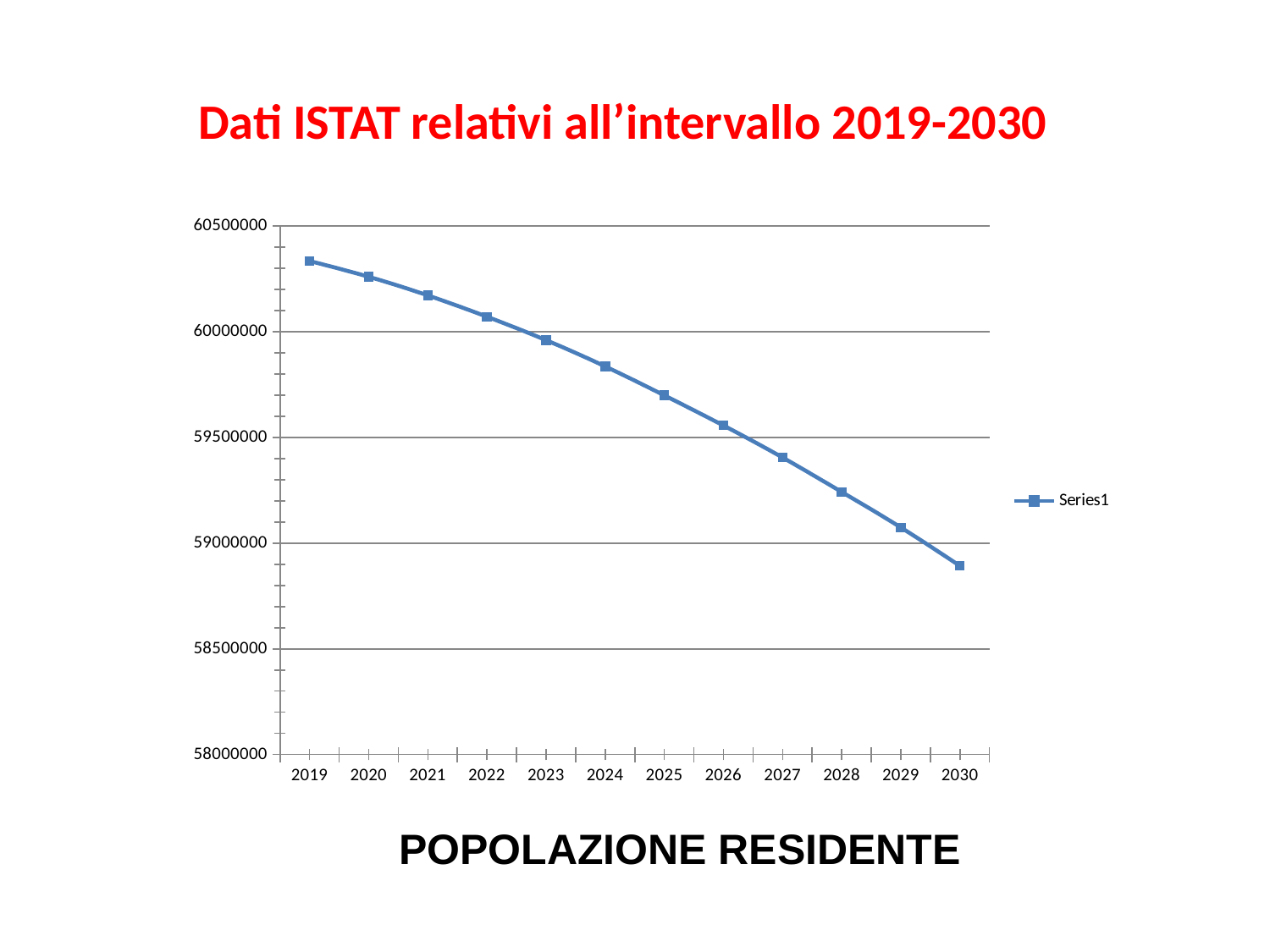
Do the values rise or fall from 2019 to 2030? fall What is the name of the series shown in the legend? Series1 Which year has the larger value, 2021 or 2028? 2021 What kind of chart is shown on the slide? line chart Which year has the highest value? 2019 Which year has the lowest value? 2030 Is the value for 2030 greater or less than 59000000? less Is the value for 2019 greater or less than 60000000? greater Is the value for 2027 greater or less than 59500000? less How many series does the legend list? 1 How many years are plotted along the x axis? 12